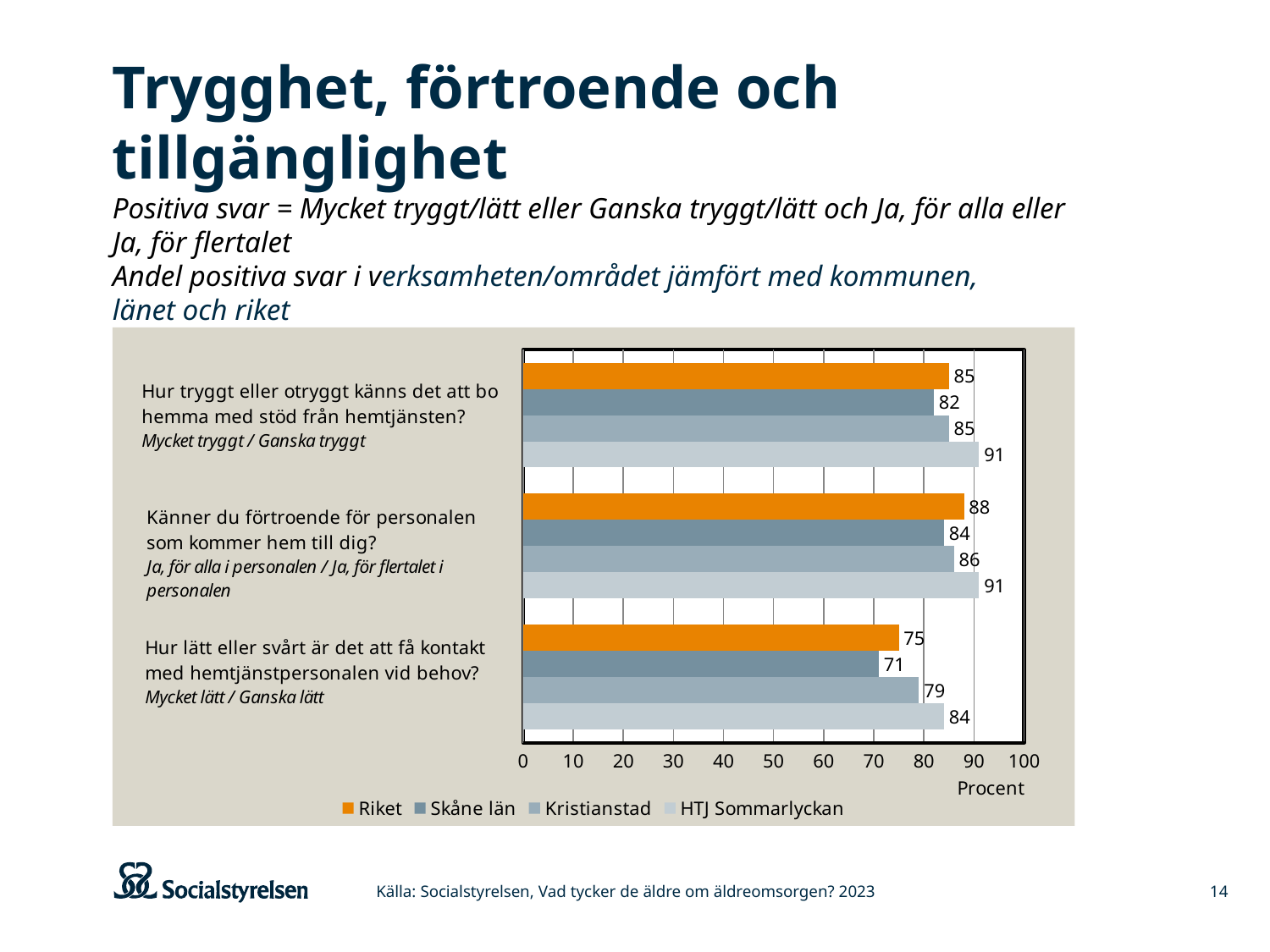
What is the value for Kristianstad on the question "Hur lätt eller svårt är det att få kontakt med hemtjänstpersonalen vid behov?"? 79 What is the value for HTJ Sommarlyckan on the question "Hur tryggt eller otryggt känns det att bo hemma med stöd från hemtjänsten?"? 91 What kind of chart is shown on the slide? Bar chart How many series does the legend list? 4 Is the value for Riket on the question "Hur lätt eller svårt är det att få kontakt med hemtjänstpersonalen vid behov?" greater or less than 80? less What is the difference between HTJ Sommarlyckan and Skåne län on the question "Hur lätt eller svårt är det att få kontakt med hemtjänstpersonalen vid behov?"? 13 Which is larger on the question "Känner du förtroende för personalen som kommer hem till dig?": Riket or Kristianstad? Riket Which series has the lowest value on the question "Hur lätt eller svårt är det att få kontakt med hemtjänstpersonalen vid behov?"? Skåne län How many question categories are shown on the chart? 3 What is the value for Riket on the question "Känner du förtroende för personalen som kommer hem till dig?"? 88 What is the value for Skåne län on the question "Hur lätt eller svårt är det att få kontakt med hemtjänstpersonalen vid behov?"? 71 Which series has the highest value on the question "Känner du förtroende för personalen som kommer hem till dig?"? HTJ Sommarlyckan